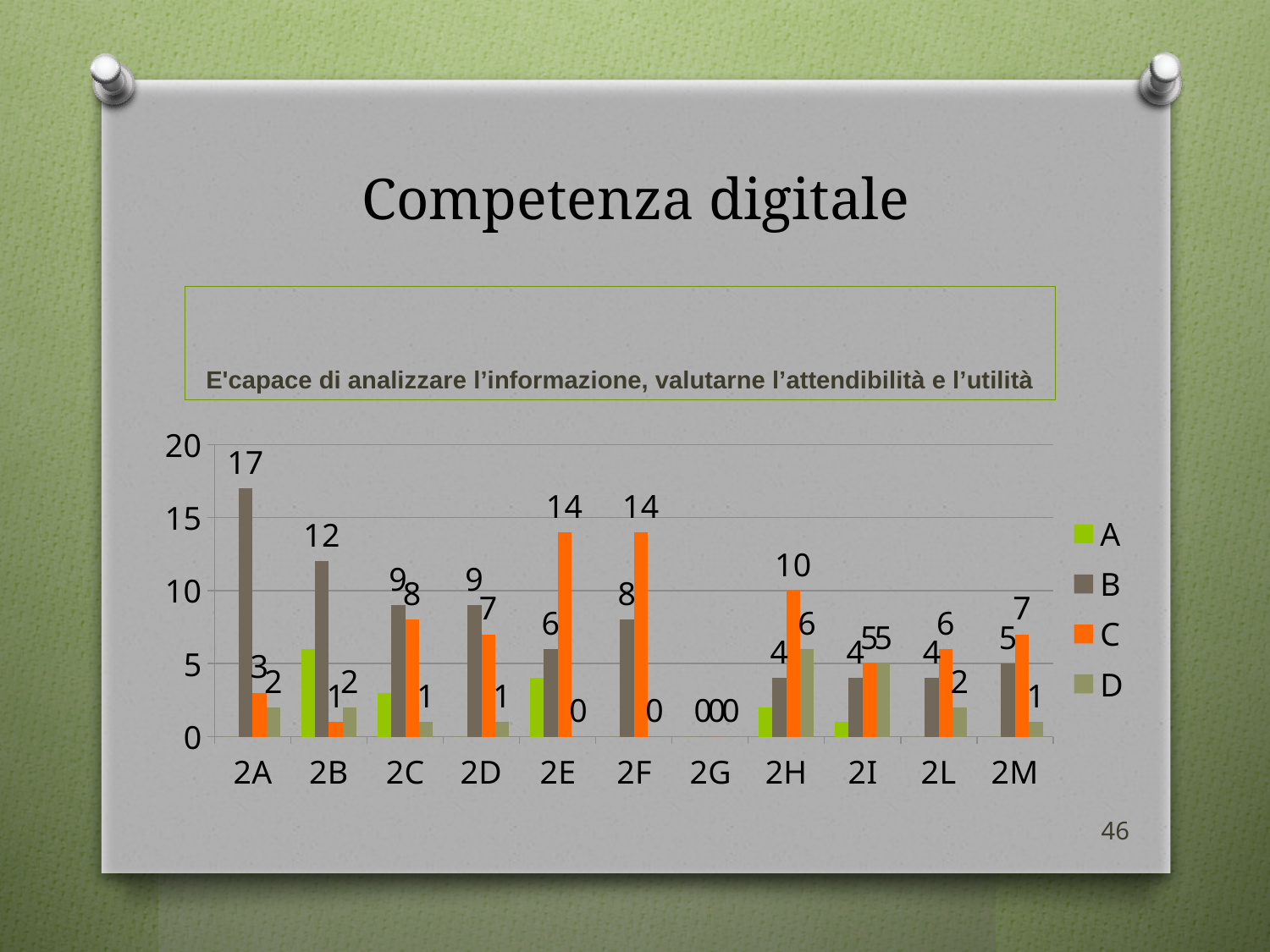
How many categories are shown on the x axis? 11 What is the value of series C for 2H? 10 Is the value of series A for 2H greater or less than 5? less What is the title of the slide containing the chart? Competenza digitale Which category has the highest value for series B? 2A What is the value of series C for 2E? 14 For 2C, which is larger: series B or series C? B How many series does the legend list? 4 What is the value of series B for 2A? 17 What is the value of series D for 2H? 6 What is the difference between the series B values for 2A and 2B? 5 What kind of chart is shown on the slide? bar chart